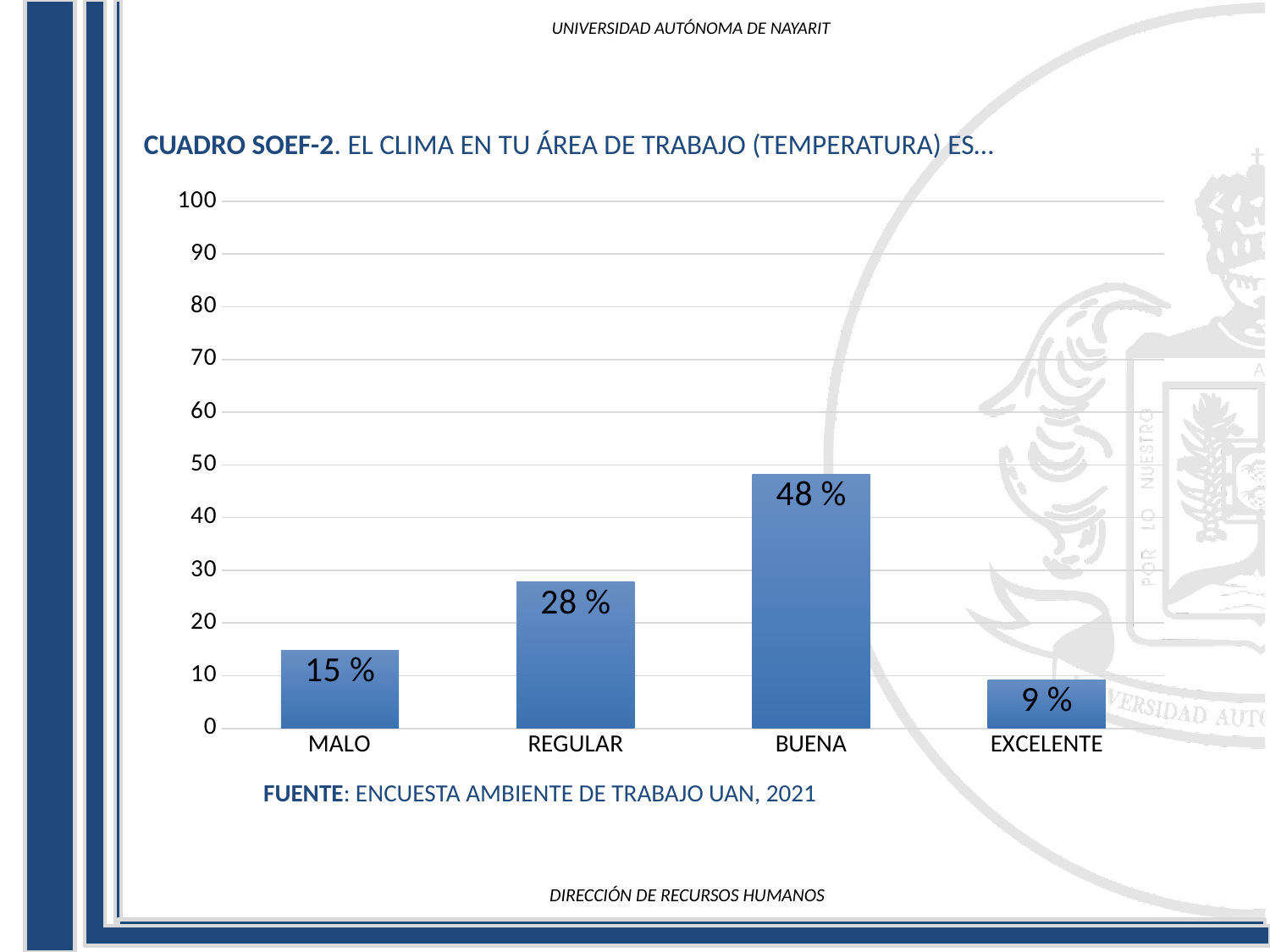
Is the value for REGULAR greater or less than 30? less What is the value for EXCELENTE? 9 % Which category has the highest value? BUENA What kind of chart is shown on the slide? bar chart What is the value for MALO? 15 % Which category has the lowest value? EXCELENTE Which is larger, the value for MALO or the value for REGULAR? REGULAR What is the highest value shown on the y axis? 100 What is the value for BUENA? 48 % What is the source cited below the chart? ENCUESTA AMBIENTE DE TRABAJO UAN, 2021 What is the difference between the values for BUENA and REGULAR? 20 % How many categories are shown on the x axis? 4